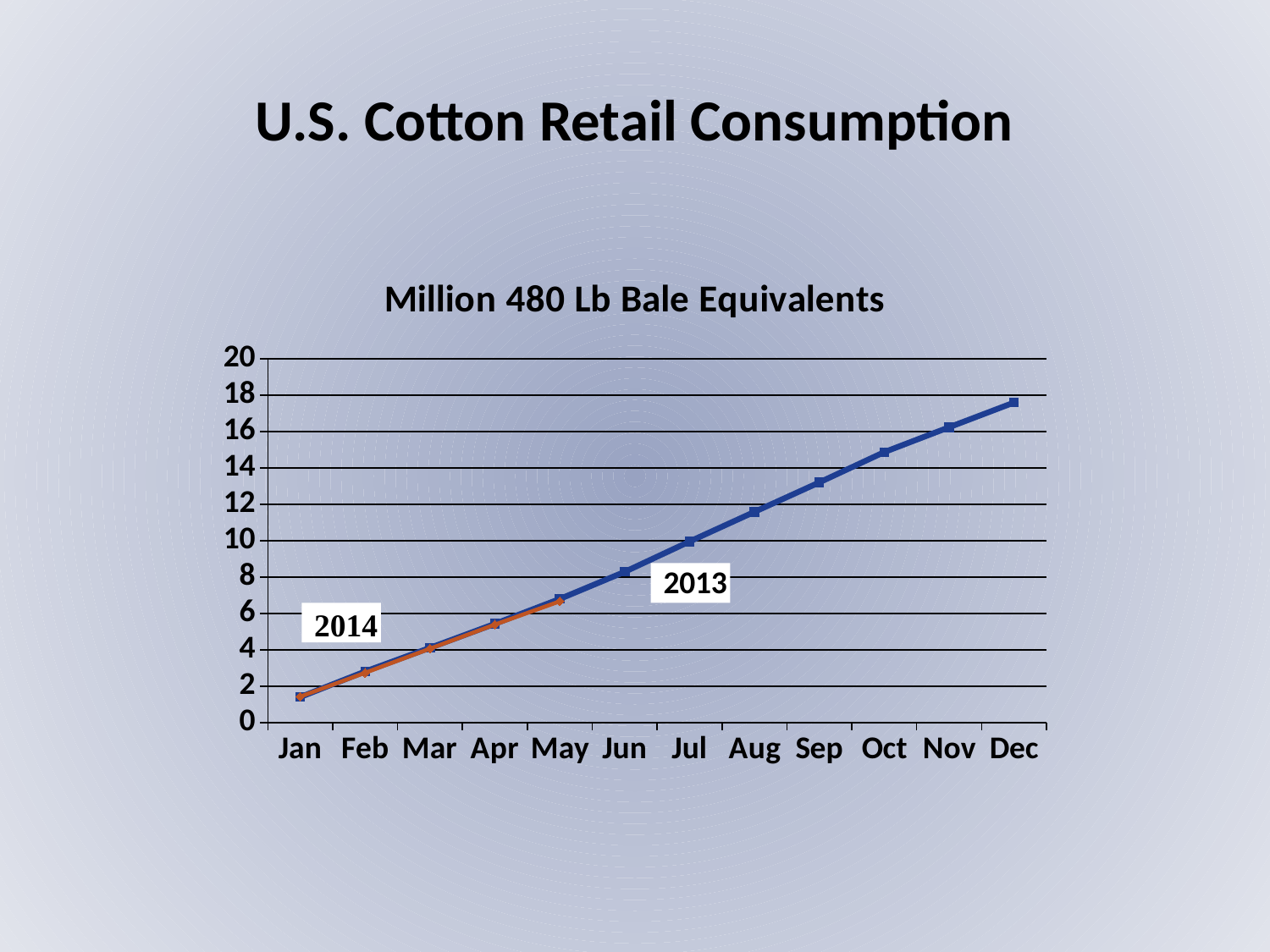
Which is larger for the 2013 series, the value for Sep or the value for Jun? Sep How many data series are plotted on the chart? 2 What unit is given in the chart's subtitle? Million 480 Lb Bale Equivalents Is the 2013 value for Dec greater or less than 16? greater Do the values for the 2013 series rise or fall from Jan to Dec? rise Is the 2013 value for Jan greater or less than 2? less Which years are the two series labelled on the chart? 2013 and 2014 In which month does the 2013 series reach its highest value? Dec Is the 2014 value for May greater or less than 6? greater How many months are shown on the x axis of the chart? 12 What kind of chart is shown on the slide? line chart In which month is the 2013 series at its lowest value? Jan